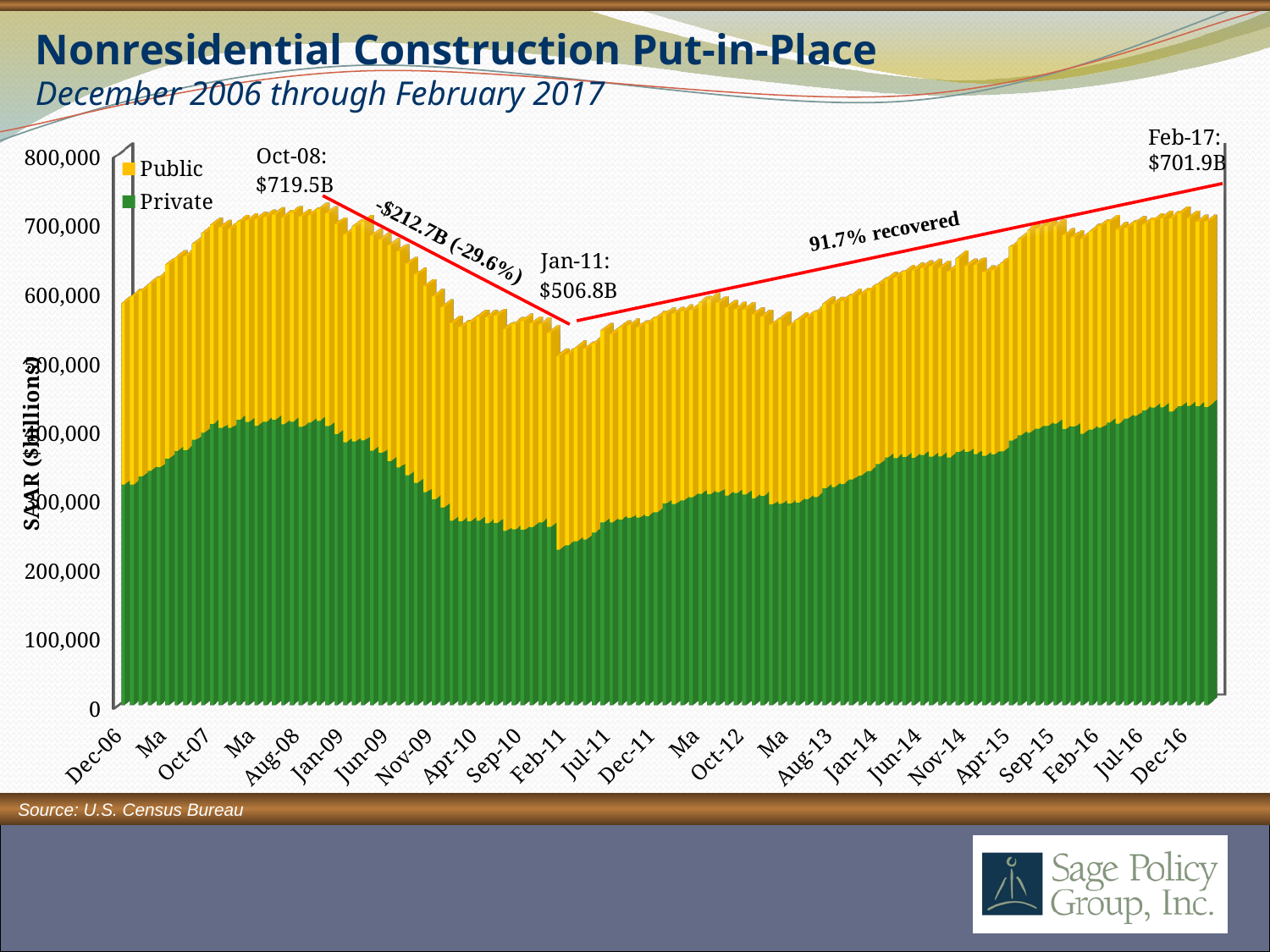
What percentage decline is annotated between Oct-08 and Jan-11? -29.6% Is the total value for Dec-06 greater or less than 500,000? greater What was the value of nonresidential construction put-in-place in Oct-08? $719.5B What was the value of nonresidential construction put-in-place in Jan-11? $506.8B What kind of chart is shown on the slide? Stacked bar chart Do the total values rise or fall from Jan-11 to Feb-17? rise By how much did nonresidential construction put-in-place decline from Oct-08 to Jan-11? $212.7B What colour represents the Public series in the chart? Yellow What was the value of nonresidential construction put-in-place in Feb-17? $701.9B Which is larger, the total for Oct-08 or the total for Feb-17? Oct-08 How many series does the legend list? 2 Is the Private value for Feb-11 greater or less than 300,000? less